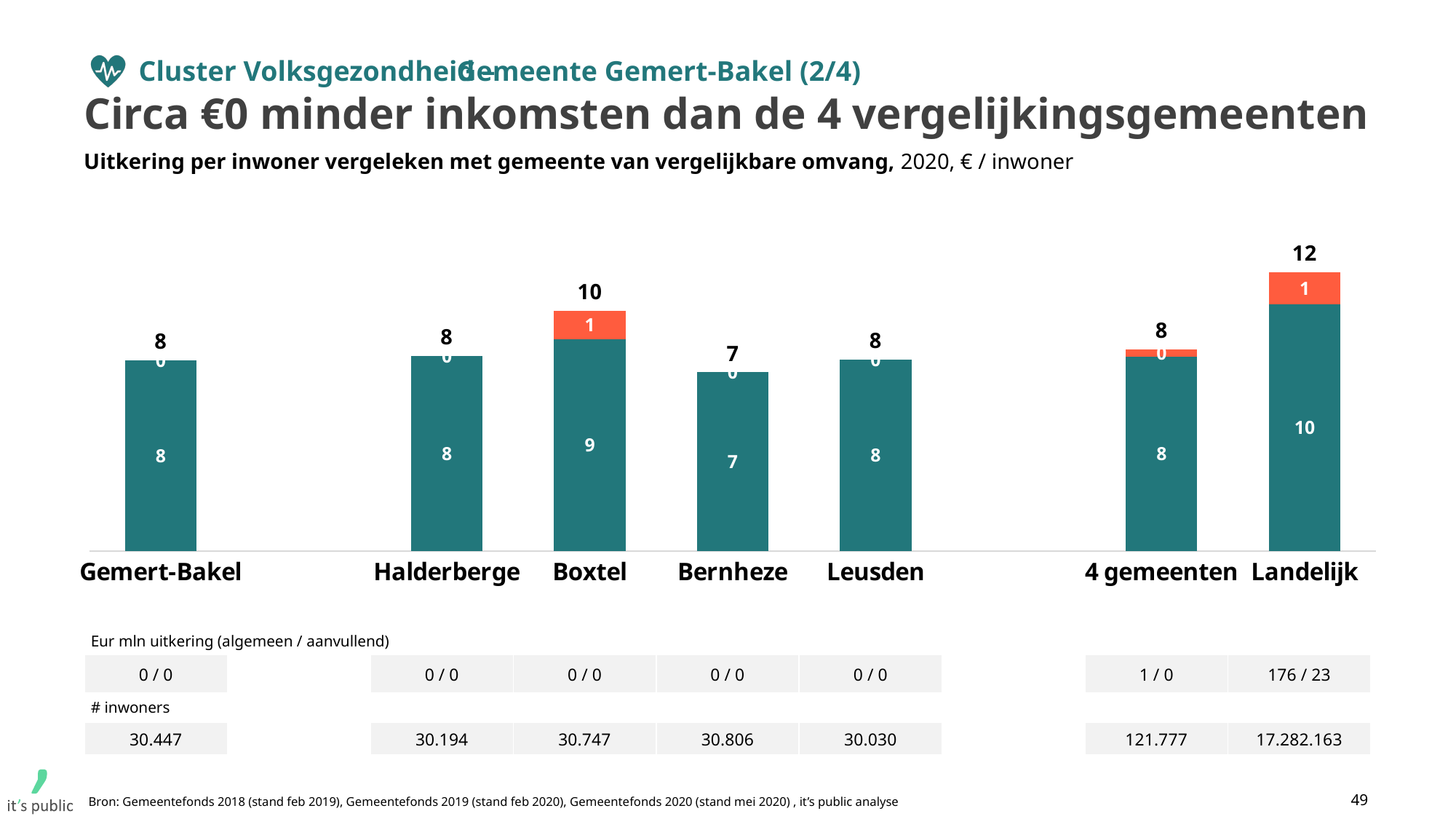
What kind of chart is shown on the slide? Stacked bar chart What is the total value shown above the bar for Boxtel? 10 Which category has the lowest total value? Bernheze Which has a larger total value, Boxtel or Leusden? Boxtel What is the value of the teal (lower) segment of the Landelijk bar? 10 What is the difference between the total for Landelijk and the total for Gemert-Bakel? 4 What is the total value shown above the bar for Bernheze? 7 What is the difference between the total for Boxtel and the total for Bernheze? 3 Which category has the highest total value? Landelijk What is the total of the stacked bar for 4 gemeenten? 8 How many categories are shown on the x axis of the chart? 7 What is the value of the orange (upper) segment of the Boxtel bar? 1